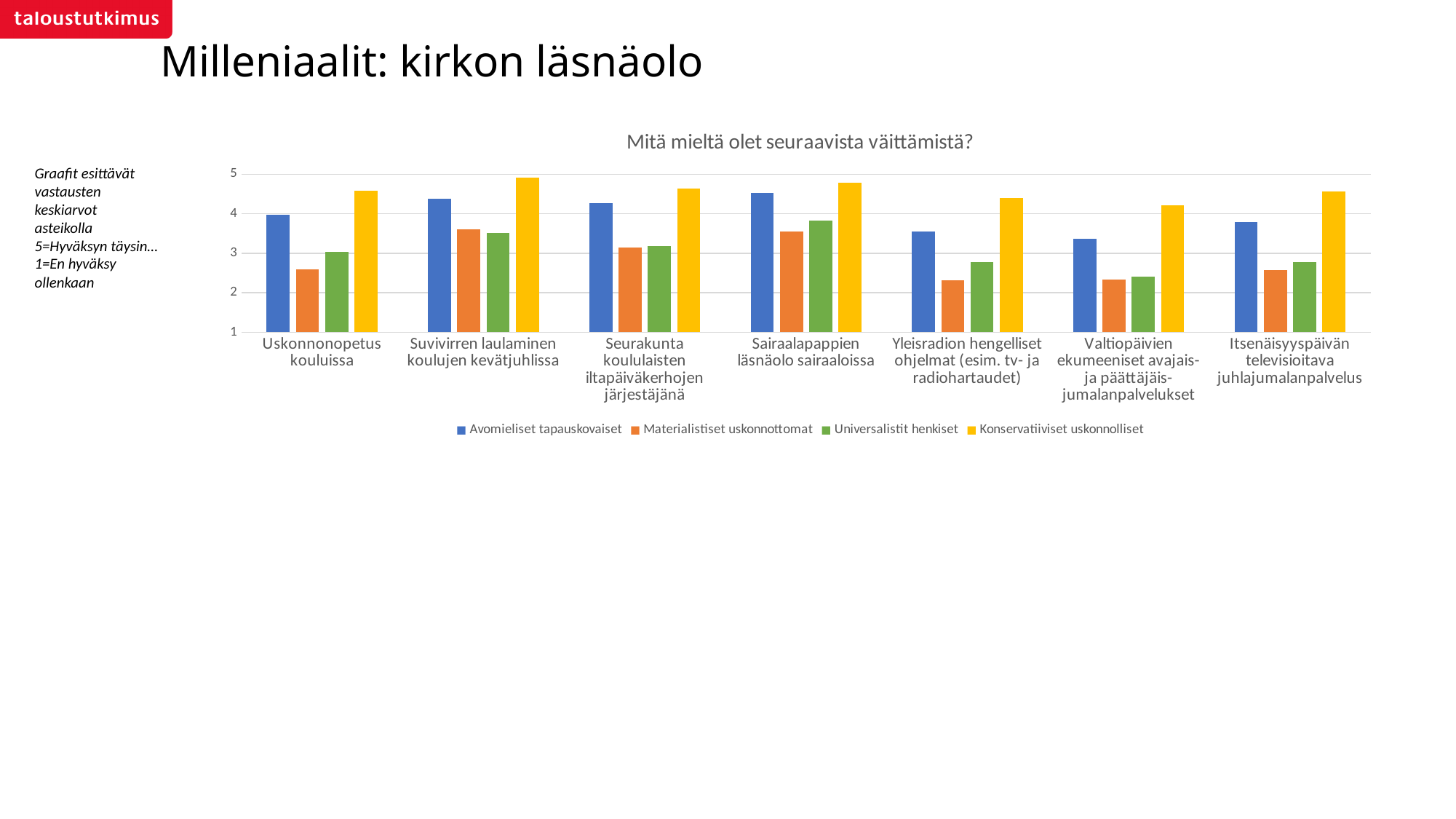
For which statement is the value for Universalistit henkiset lowest? Valtiopäivien ekumeeniset avajais- ja päättäjäisjumalanpalvelukset Is the value for Avomieliset tapauskovaiset on Yleisradion hengelliset ohjelmat greater or less than 4? less Is the value for Avomieliset tapauskovaiset on Suvivirren laulaminen koulujen kevätjuhlissa greater or less than 4? greater For which statement is the value for Konservatiiviset uskonnolliset lowest? Valtiopäivien ekumeeniset avajais- ja päättäjäisjumalanpalvelukset How many series does the legend list? 4 How many statement categories are shown on the x axis? 7 What is the title of the chart? Mitä mieltä olet seuraavista väittämistä? For Uskonnonopetus kouluissa, which is larger: the value for Universalistit henkiset or for Materialistiset uskonnottomat? Universalistit henkiset Is the value for Materialistiset uskonnottomat on Uskonnonopetus kouluissa greater or less than 3? less What kind of chart is shown on the slide? bar chart Which colour represents the series Konservatiiviset uskonnolliset? yellow For which statement is the value for Universalistit henkiset highest? Sairaalapappien läsnäolo sairaaloissa